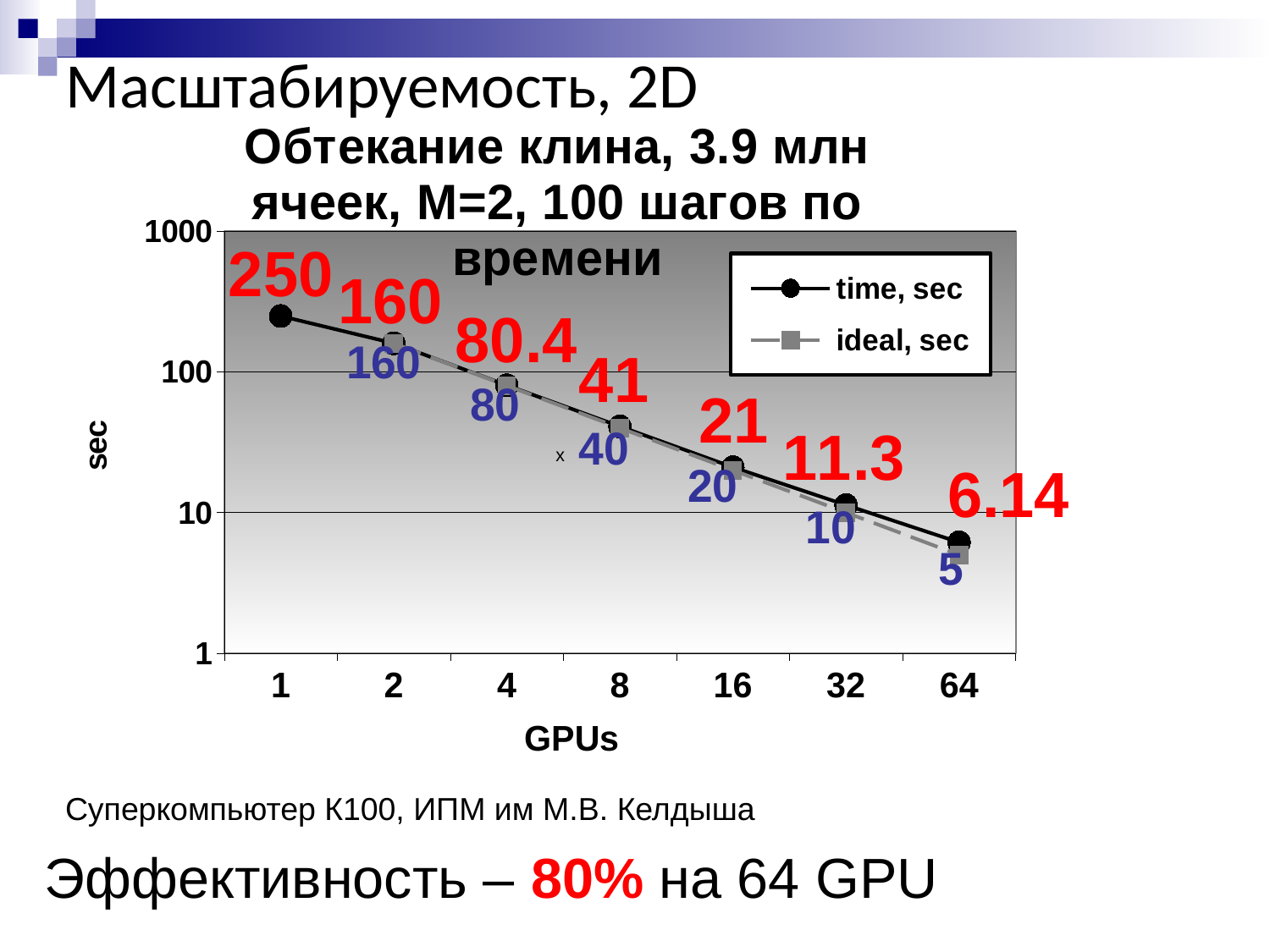
At which number of GPUs is the "time, sec" value highest? 1 What is the value of the "time, sec" series at 4 GPUs? 80.4 How many series does the legend list? 2 What is the value of the "ideal, sec" series at 32 GPUs? 10 What is the difference between the "time, sec" and "ideal, sec" values at 64 GPUs? 1.14 Which is larger at 32 GPUs: the "time, sec" value or the "ideal, sec" value? time, sec At which number of GPUs is the "time, sec" value lowest? 64 What is the value of the "time, sec" series at 64 GPUs? 6.14 Is the "time, sec" value at 16 GPUs greater or less than 10? greater What kind of chart is shown on the slide? line chart How many GPU counts are plotted on the x axis? 7 Does the "time, sec" series rise or fall as the number of GPUs increases? fall